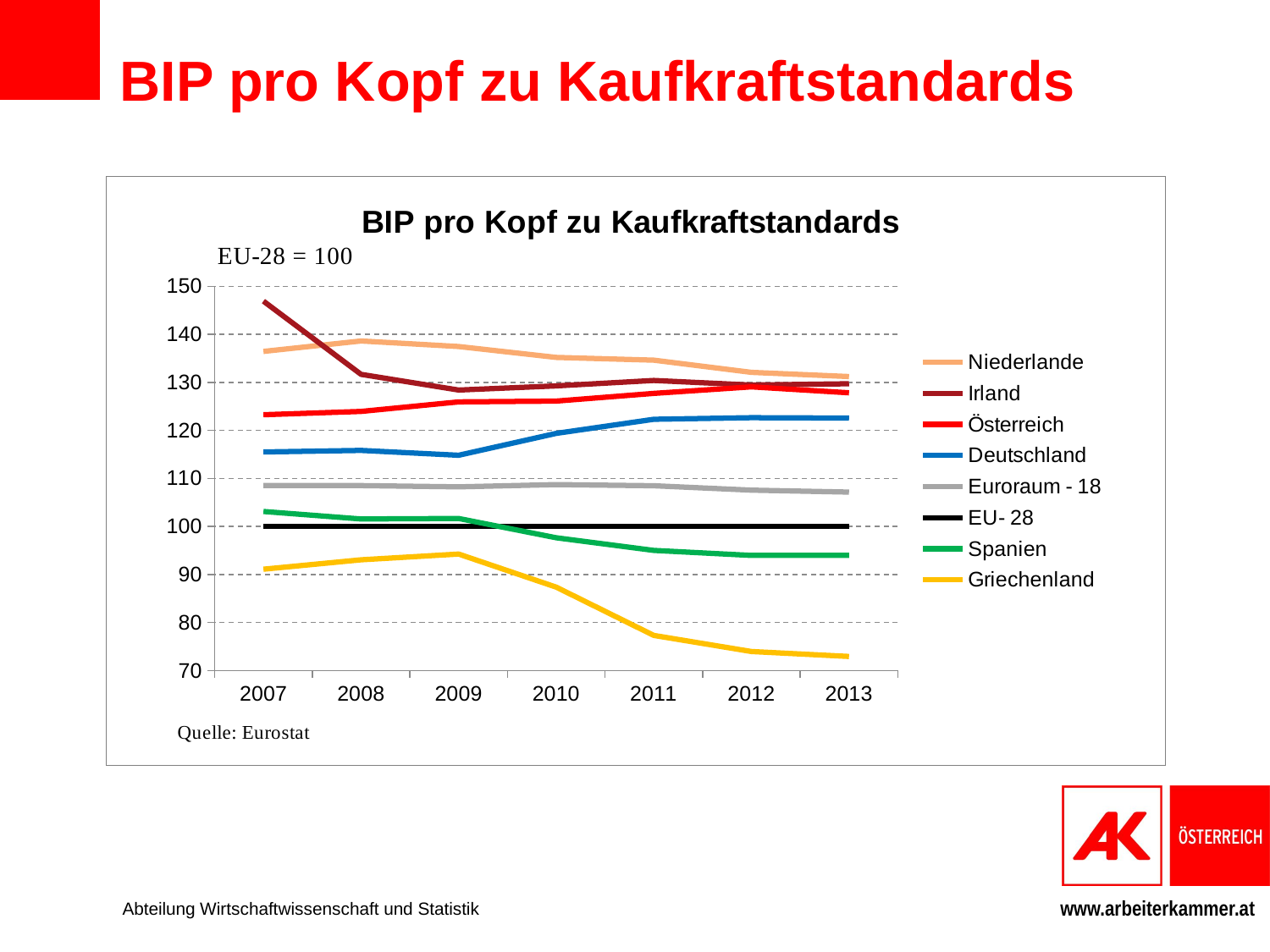
Is the value for Spanien in 2013 greater or less than 100? less Does the line for Griechenland rise or fall from 2009 to 2013? fall Does the line for Deutschland rise or fall from 2009 to 2013? rise Which is larger in 2013, the value for Niederlande or for Deutschland? Niederlande Is the value for Irland in 2007 greater or less than 140? greater Which series has the lowest value in 2013? Griechenland How many series does the legend list? 8 What kind of chart is shown on the slide? line chart Is the value for Griechenland in 2013 greater or less than 80? less How many years are shown on the x axis? 7 What is the value for EU-28 in 2010? 100 Which series has the highest value in 2007? Irland